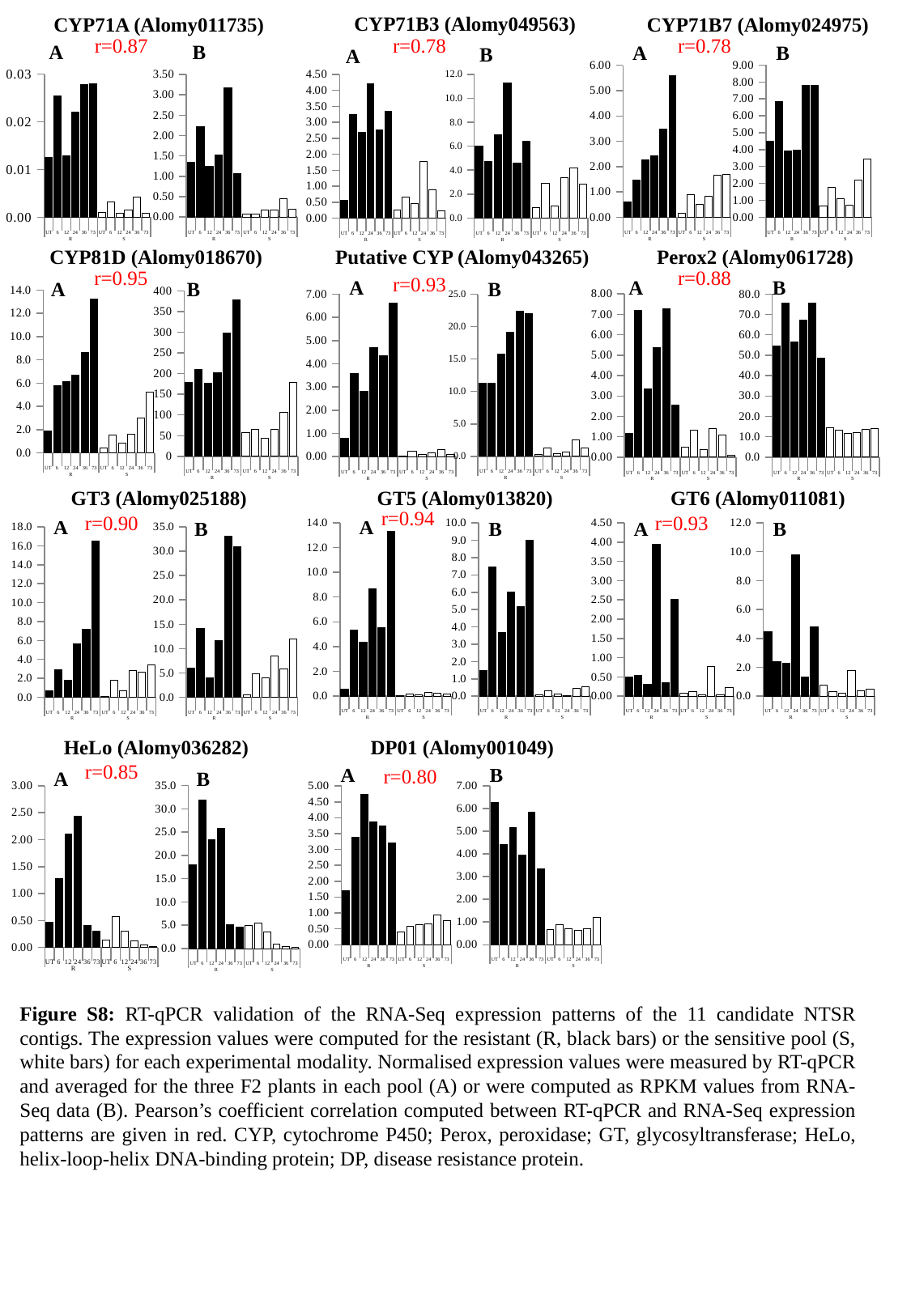
What kind of chart is used in each panel of the figure? bar chart In the CYP81D (Alomy018670) panel A chart, is the tallest black bar greater or less than 12.0? greater How many candidate contigs (gene panels) are shown in the figure? 11 In the DP01 (Alomy001049) panel A chart, is the tallest black bar greater or less than 4.00? greater What Pearson correlation coefficient is given in red for CYP81D (Alomy018670)? r=0.95 In the CYP71A (Alomy011735) panel A chart, which pool shows higher expression values overall, the resistant (black bars) or the sensitive (white bars)? resistant (black bars) What Pearson correlation coefficient is given in red for DP01 (Alomy001049)? r=0.80 In the HeLo (Alomy036282) panel B chart, is the tallest black bar greater or less than 30.0? greater